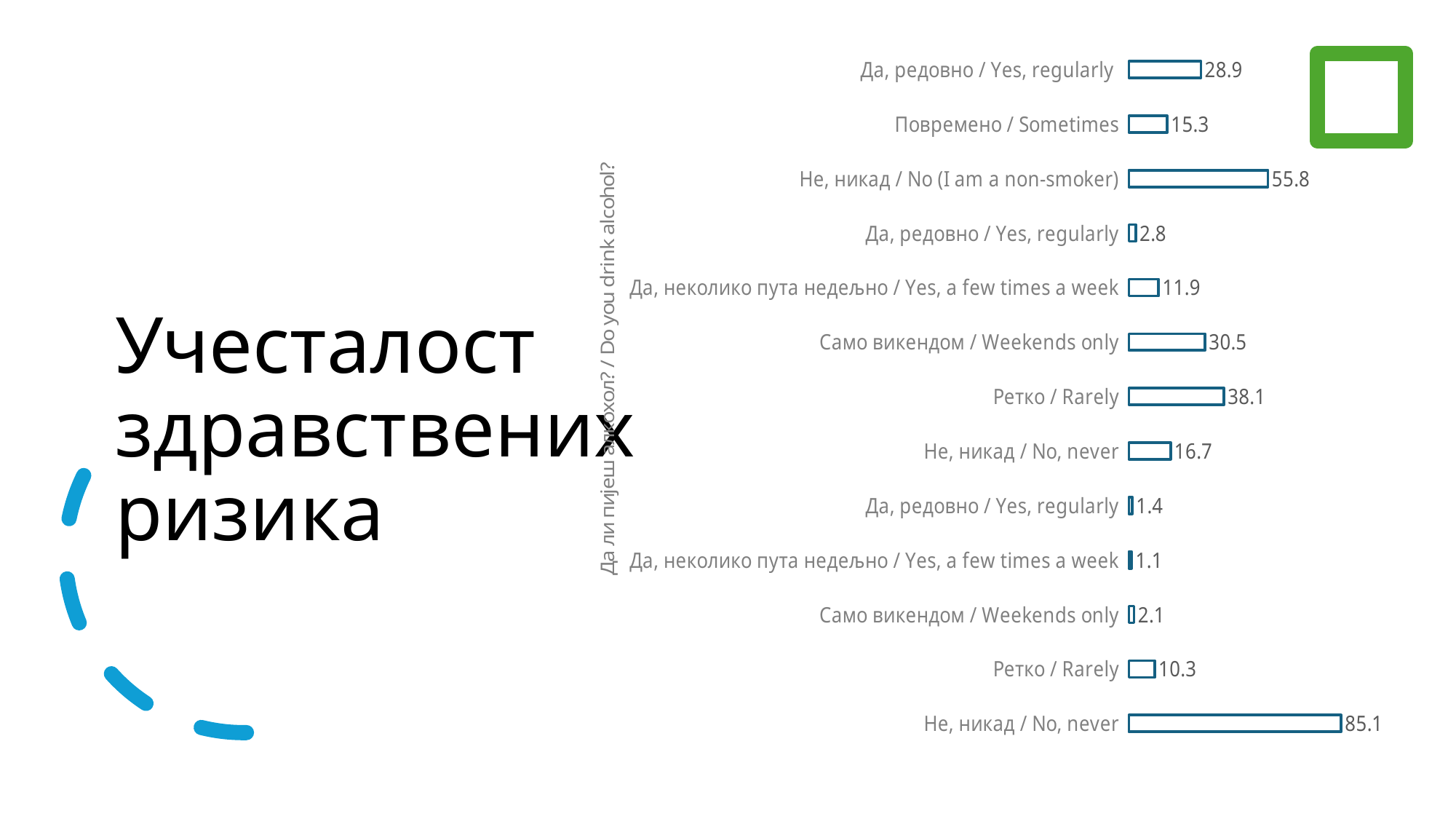
What is the difference between the value for "Не, никад / No (I am a non-smoker)" and the top-most "Да, редовно / Yes, regularly" bar? 26.9 What is the value of the top-most bar, labelled "Да, редовно / Yes, regularly"? 28.9 What type of chart is shown on the slide? Bar chart Which bar has the highest value on the chart? Не, никад / No, never (the bottom bar), 85.1 What is the value for "Повремено / Sometimes"? 15.3 How many bars are labelled "Да, редовно / Yes, regularly"? 3 What is the value for "Не, никад / No (I am a non-smoker)"? 55.8 How many bars are plotted on the chart? 13 What is the difference between the upper "Ретко / Rarely" bar (38.1) and the upper "Само викендом / Weekends only" bar (30.5)? 7.6 What is the value of the bottom-most bar, labelled "Не, никад / No, never"? 85.1 Which is larger: the value for "Повремено / Sometimes" or for "Не, никад / No (I am a non-smoker)"? Не, никад / No (I am a non-smoker) Which bar has the lowest value on the chart? Да, неколико пута недељно / Yes, a few times a week (the lower one), 1.1